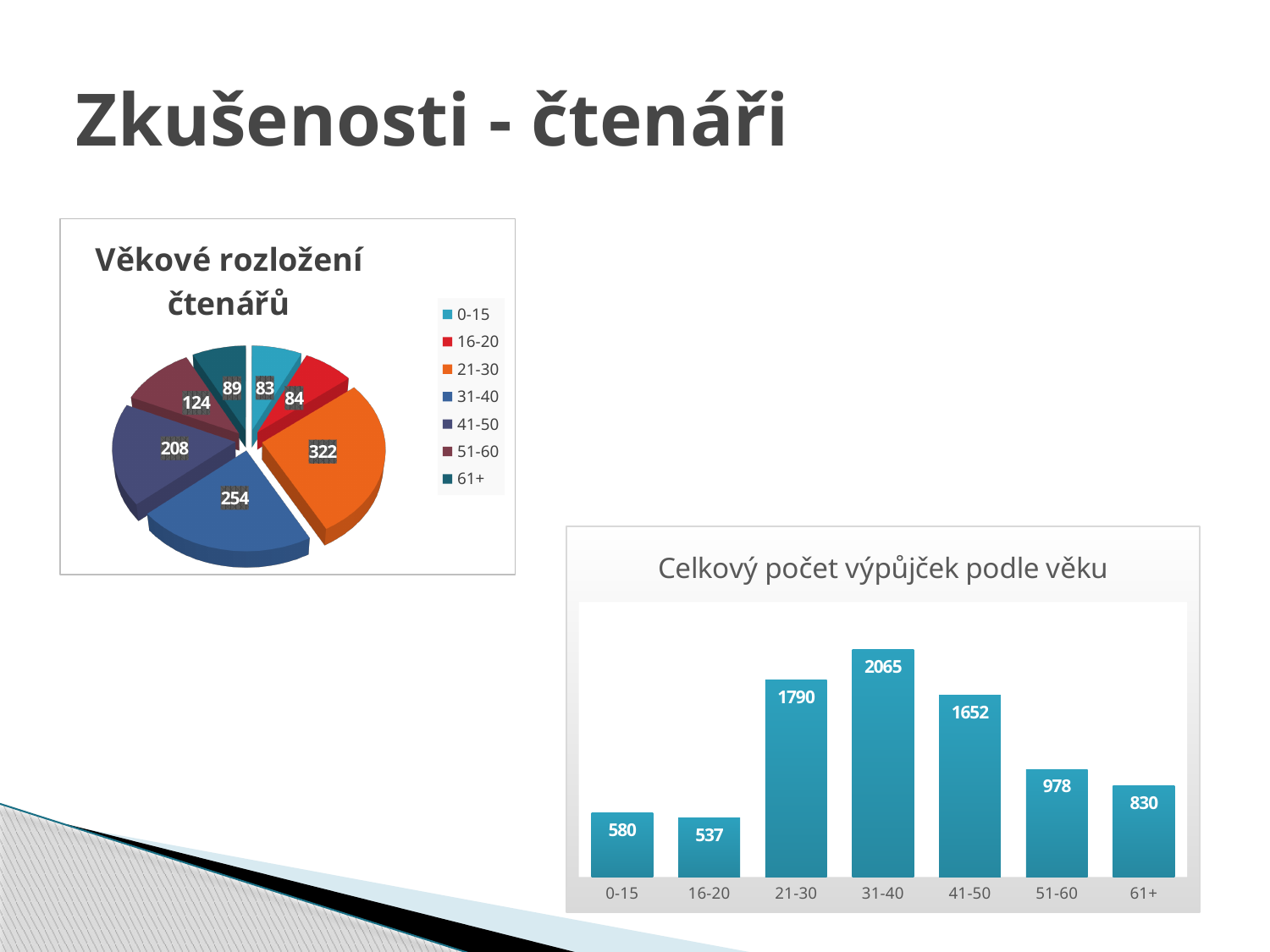
What kind of chart is 'Celkový počet výpůjček podle věku'? bar chart In the bar chart 'Celkový počet výpůjček podle věku', which is larger, the value for 41-50 or the value for 51-60? 41-50 In the bar chart 'Celkový počet výpůjček podle věku', which age group has the highest value? 31-40 In the bar chart 'Celkový počet výpůjček podle věku', what is the value for the 61+ age group? 830 In the bar chart 'Celkový počet výpůjček podle věku', which age group has the lowest value? 16-20 In the pie chart 'Věkové rozložení čtenářů', what is the value for the 21-30 age group? 322 How many age groups are shown in the bar chart 'Celkový počet výpůjček podle věku'? 7 In the bar chart 'Celkový počet výpůjček podle věku', what is the difference between the values for 31-40 and 21-30? 275 In the pie chart 'Věkové rozložení čtenářů', what is the value for the 51-60 age group? 124 How many entries does the legend of the pie chart 'Věkové rozložení čtenářů' list? 7 In the pie chart 'Věkové rozložení čtenářů', which age group has the largest slice? 21-30 In the bar chart 'Celkový počet výpůjček podle věku', what is the value for the 31-40 age group? 2065